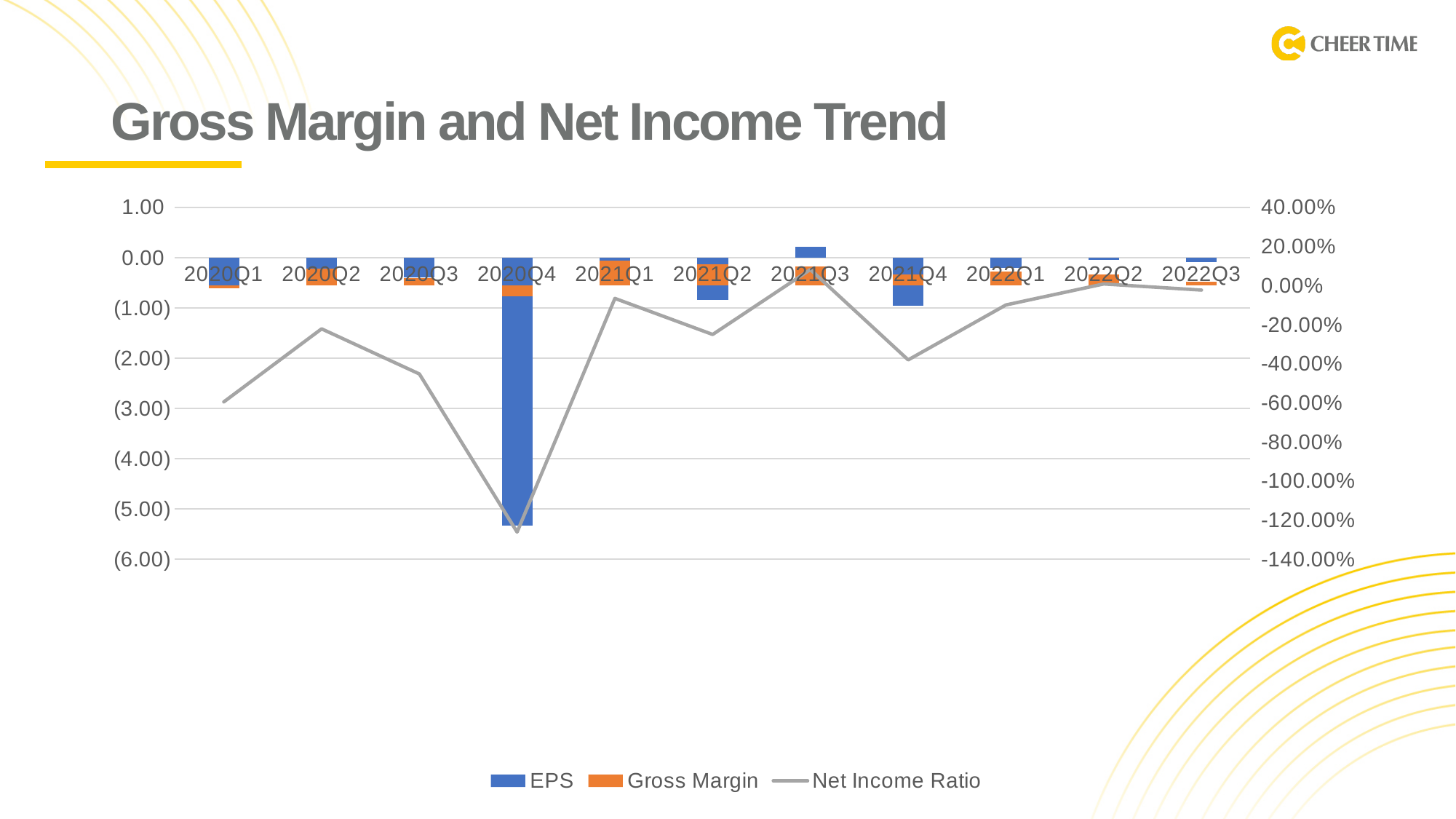
Does the Net Income Ratio line rise or fall from 2021Q4 to 2022Q3? rise Is the Net Income Ratio for 2020Q4 greater or less than -100.00%? less Is the Net Income Ratio for 2020Q1 greater or less than -40.00%? less Which quarter has the highest EPS bar? 2021Q3 What kind of chart is shown on the slide? A combined bar and line chart In which quarter does the Net Income Ratio line reach its lowest point? 2020Q4 Is the Net Income Ratio for 2021Q1 greater or less than -20.00%? greater Which quarter has the lowest EPS bar? 2020Q4 How many series does the chart legend list? 3 Which quarter has the higher Net Income Ratio, 2021Q3 or 2021Q4? 2021Q3 How many quarters are shown on the x axis of the chart? 11